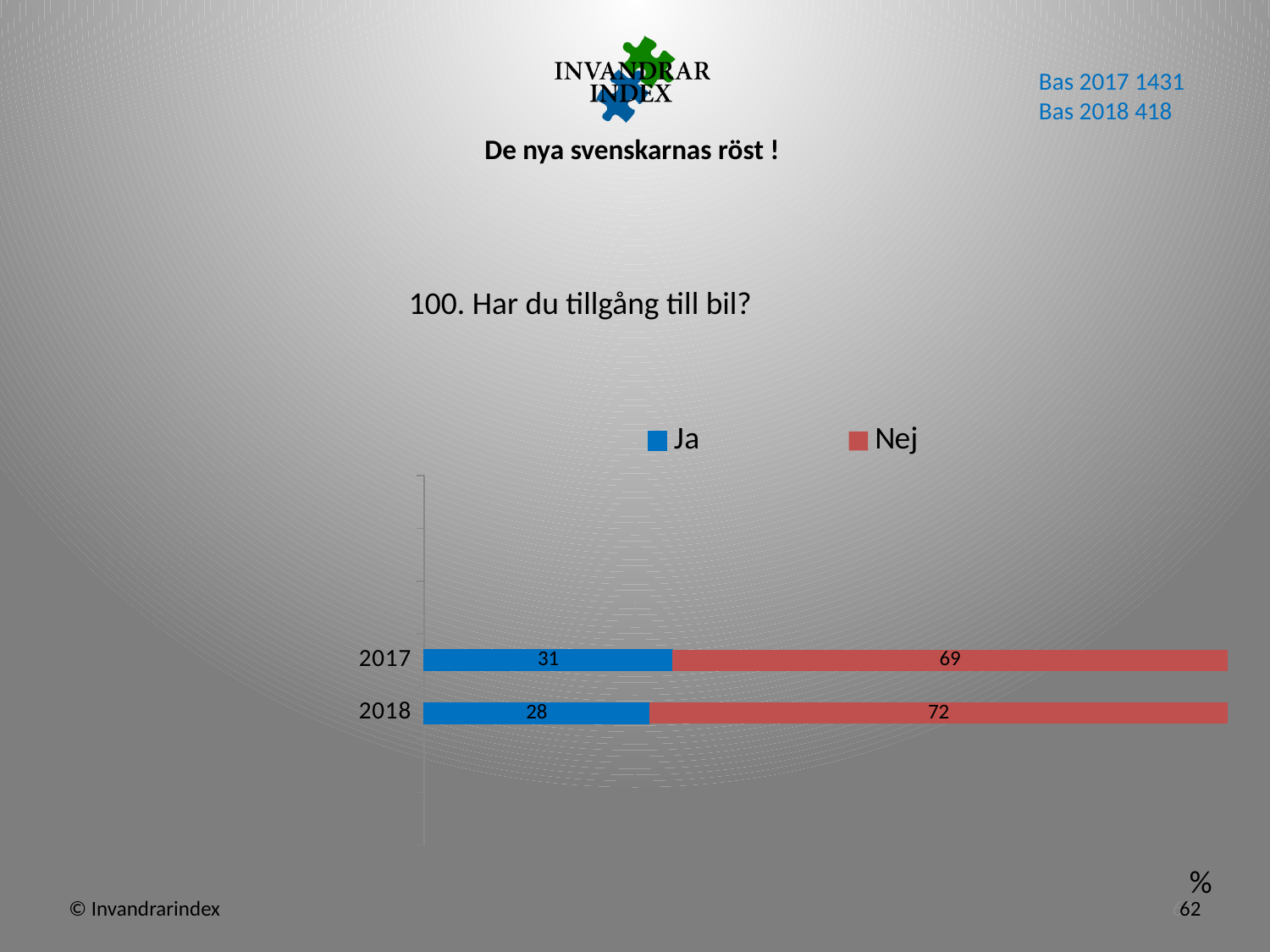
Is the Ja value larger in 2017 or in 2018? 2017 What is the value for Nej in 2017? 69 How many series does the legend list? 2 What is the value for Nej in 2018? 72 How many years are shown on the chart? 2 What is the difference between the Nej values for 2018 and 2017? 3 Which year has the lower value for Nej? 2017 What is the value for Ja in 2018? 28 What kind of chart is shown? Stacked bar chart What is the total of the stacked bar for 2018? 100 Which year has the higher value for Ja? 2017 What is the value for Ja in 2017? 31